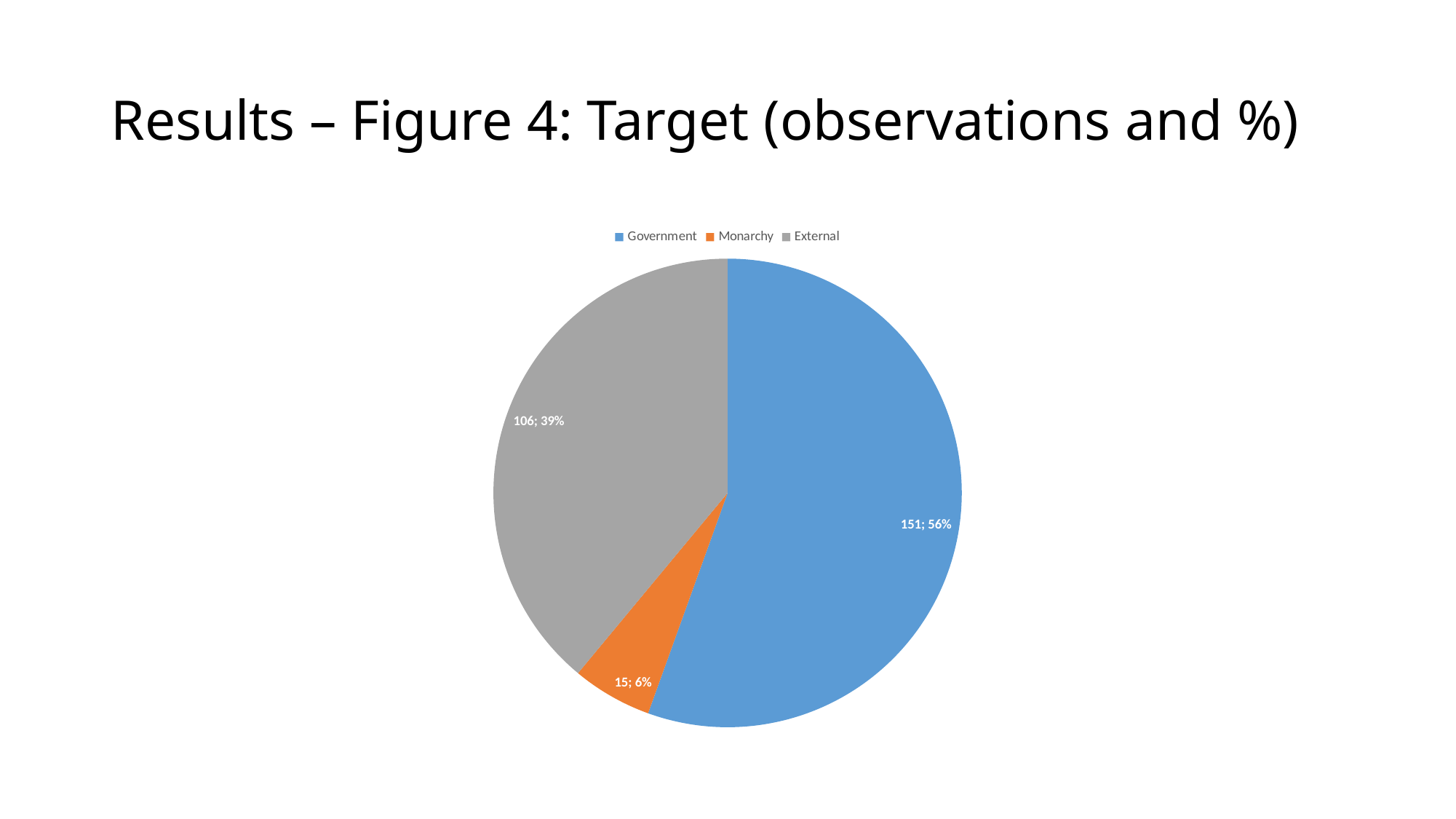
Which category has the largest slice? Government What is the total number of observations across all slices? 272 What colour is the Monarchy slice? orange How many categories does the pie chart have? 3 Which has more observations, External or Monarchy? External How many observations does the Government slice represent? 151 What percentage of the pie is the External slice? 39% What is the difference in observations between Government and External? 45 How many observations does the Monarchy slice represent? 15 Which category has the smallest slice? Monarchy What kind of chart is shown on the slide? pie chart What percentage of the pie is the Government slice? 56%